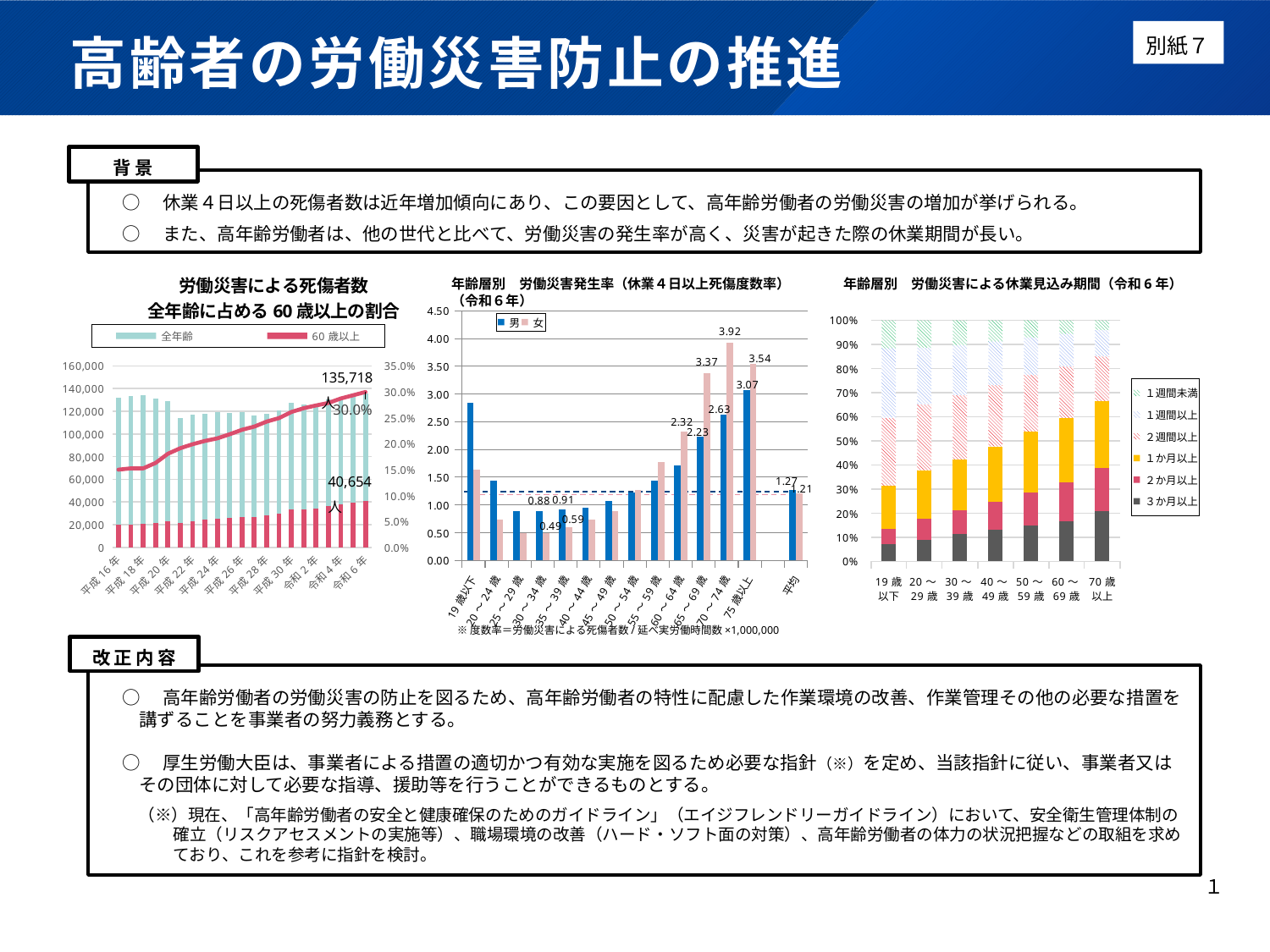
In the left chart '労働災害による死傷者数 全年齢に占める60歳以上の割合', what is the number of casualties for all ages shown for 令和6年? 135,718人 In the right chart '年齢層別 労働災害による休業見込み期間', is the share of 3か月以上 for 70歳以上 greater or less than 10%? greater In the middle chart '年齢層別 労働災害発生率', which is larger for the 75歳以上 group, 男 or 女? 女 In the left chart '労働災害による死傷者数 全年齢に占める60歳以上の割合', what is the number of casualties aged 60 and over shown for 令和6年? 40,654人 How many series does the legend of the right chart '年齢層別 労働災害による休業見込み期間' list? 6 In the middle chart '年齢層別 労働災害発生率', what is the difference between 女 (3.54) and 男 (3.07) in the 75歳以上 group? 0.47 In the left chart '労働災害による死傷者数 全年齢に占める60歳以上の割合', does the share of workers aged 60 and over rise or fall from 平成16年 to 令和6年? rise In the left chart '労働災害による死傷者数 全年齢に占める60歳以上の割合', what share of all-age casualties do those aged 60 and over account for in 令和6年? 30.0% In the middle chart '年齢層別 労働災害発生率', what is the 平均 value for 男? 1.27 In the middle chart '年齢層別 労働災害発生率', what is the value for 女 in the 70～74歳 group? 3.92 How many series does the legend of the left chart '労働災害による死傷者数 全年齢に占める60歳以上の割合' list? 2 In the middle chart '年齢層別 労働災害発生率', what is the 平均 value for 女? 1.21